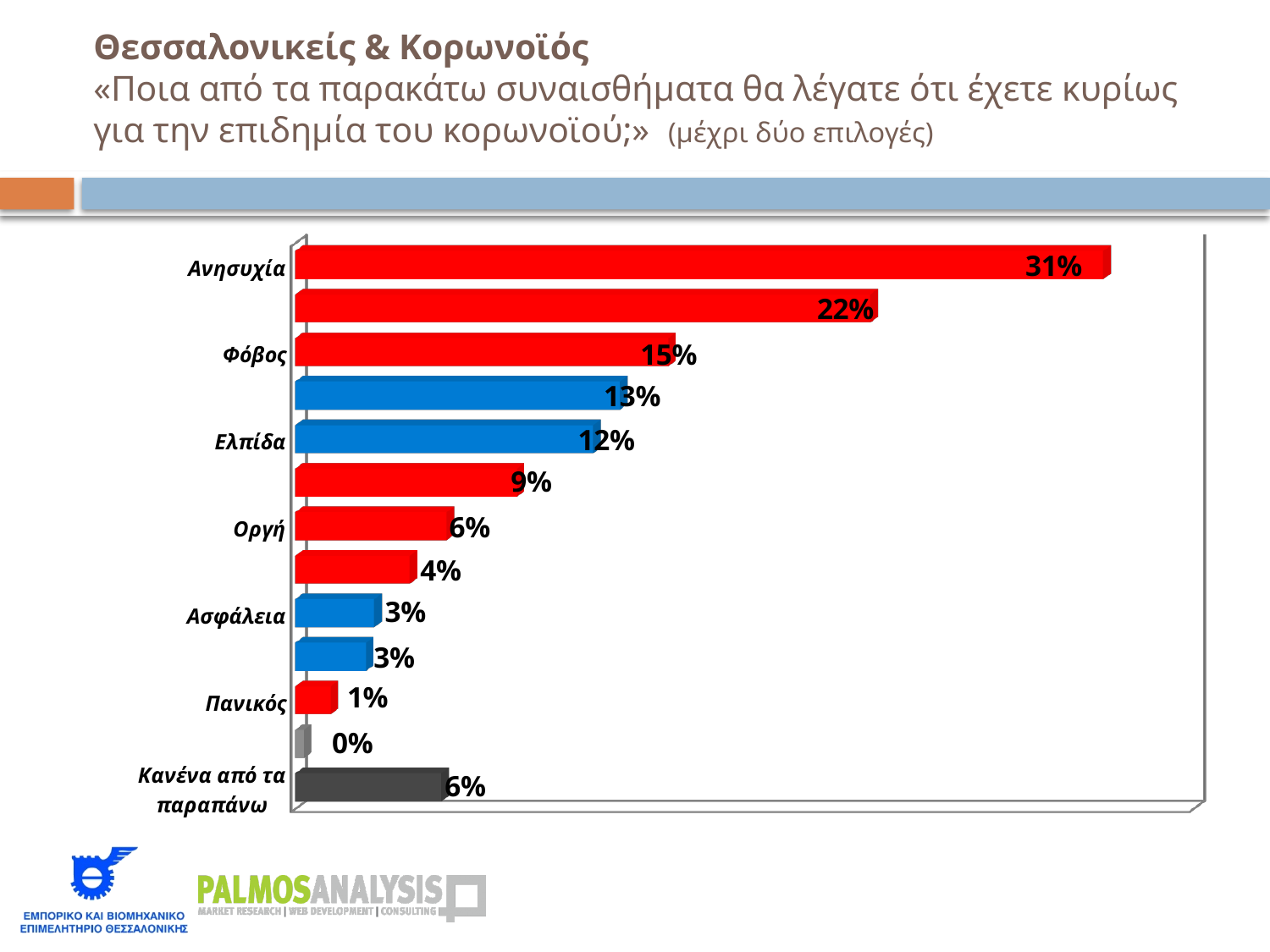
What kind of chart is shown on the slide? bar chart What is the value for Κανένα από τα παραπάνω? 6% What is the value for Πανικός? 1% What is the value for Οργή? 6% What is the difference between the values for Ανησυχία and Φόβος? 16% Which labelled category has the highest value? Ανησυχία What is the value for Ανησυχία? 31% What is the value for Φόβος? 15% What is the value for Ελπίδα? 12% How many bars are plotted in the chart? 13 What is the value for Ασφάλεια? 3% Which is larger, the value for Ελπίδα or the value for Οργή? Ελπίδα